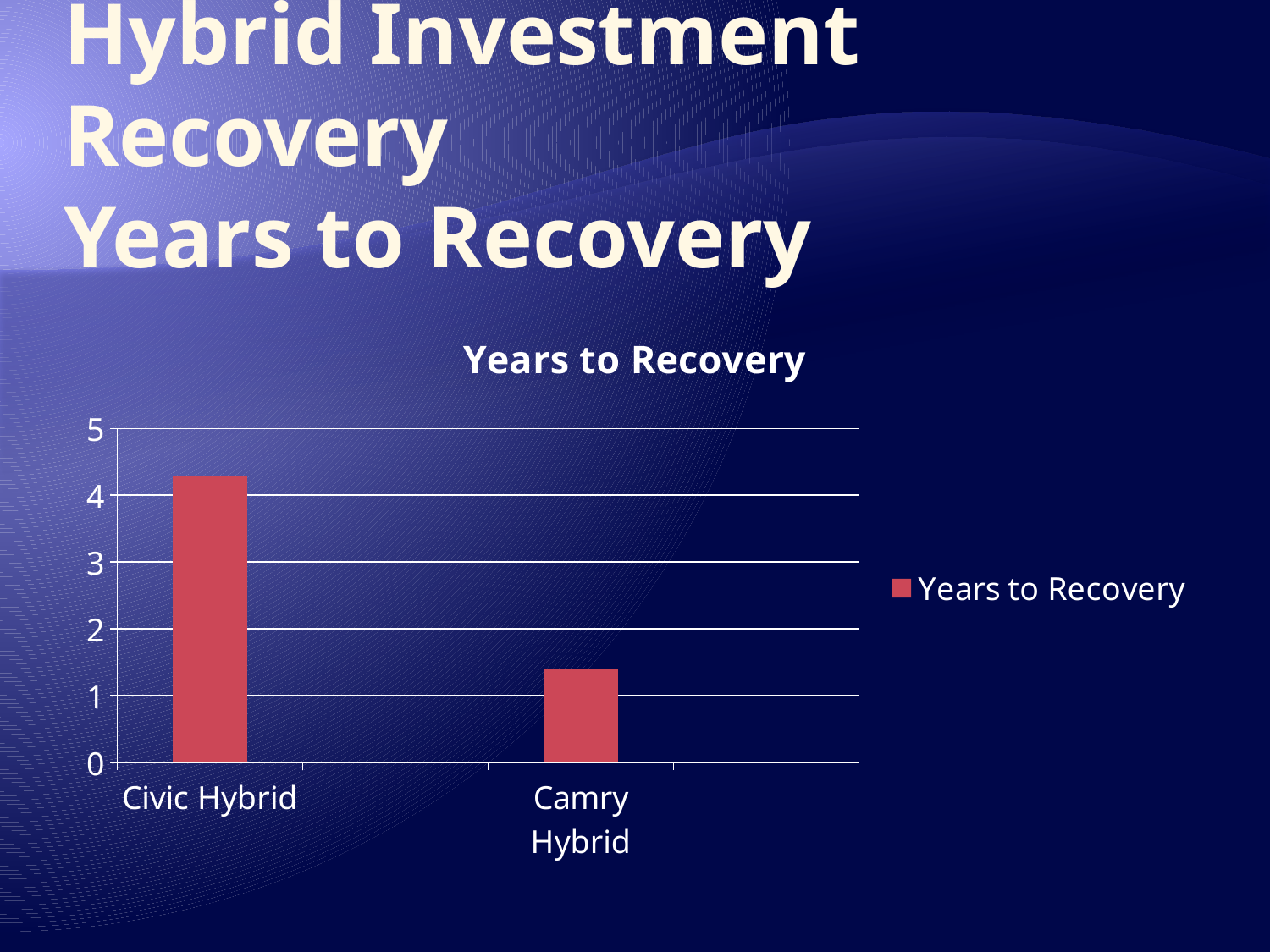
Is the value for Civic Hybrid greater or less than 4? greater Which category has the lowest years to recovery? Camry Hybrid What kind of chart is shown on the slide? bar chart Is the value for Civic Hybrid greater or less than 5? less Which category has the highest years to recovery? Civic Hybrid What is the title of the chart? Years to Recovery What series name appears in the legend? Years to Recovery How many series does the legend list? 1 Do the values rise or fall from Civic Hybrid to Camry Hybrid along the x axis? fall Is the value for Camry Hybrid greater or less than 2? less Which has a larger value, Civic Hybrid or Camry Hybrid? Civic Hybrid How many categories are shown on the x axis of the chart? 2